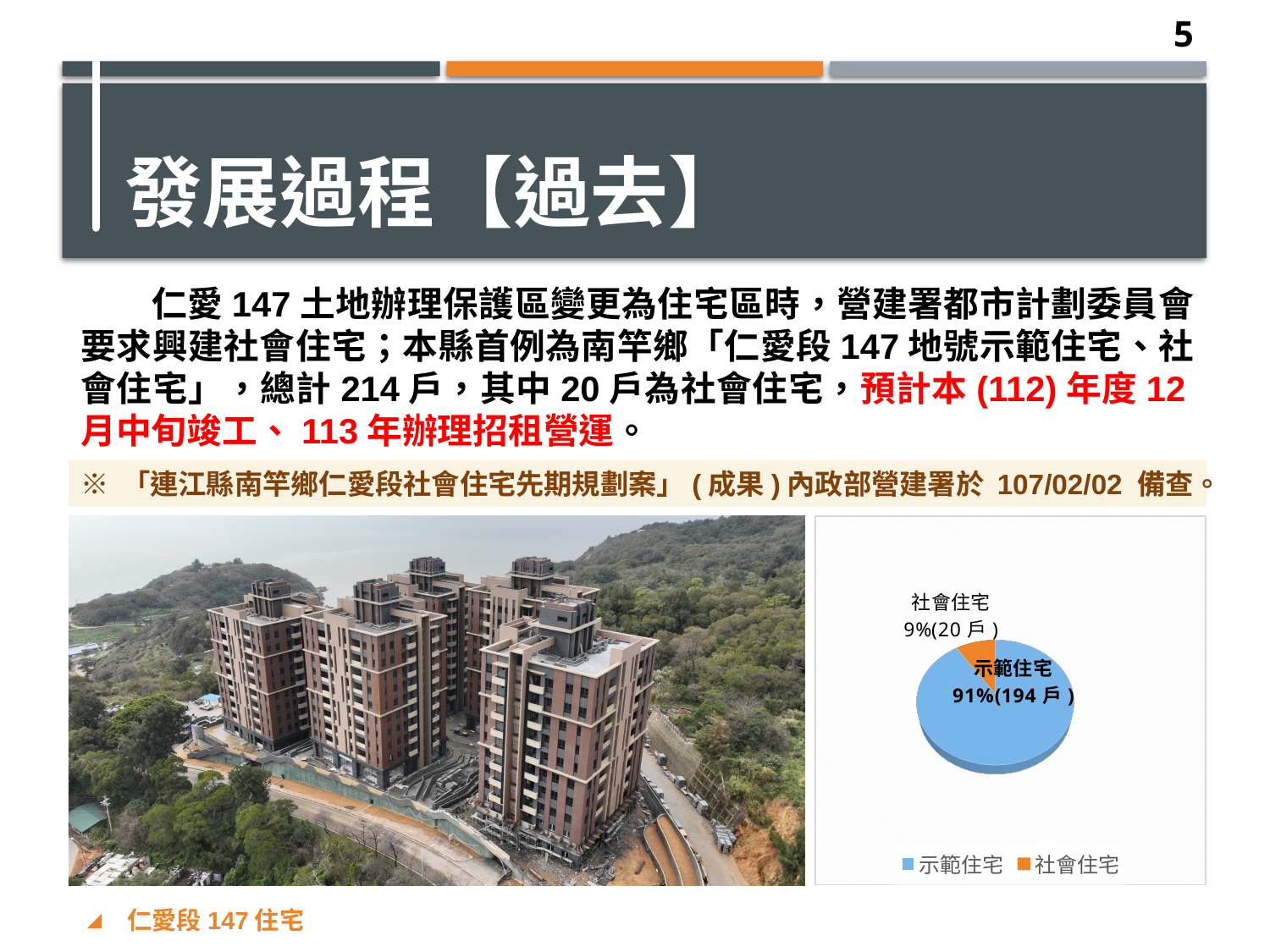
Which slice of the pie chart is the largest? 示範住宅 What percentage of the pie chart does 社會住宅 represent? 9% What is the total number of 戶 across both slices of the pie chart? 214 戶 What percentage of the pie chart does 示範住宅 represent? 91% How many 戶 are labelled for 示範住宅 in the pie chart? 194 戶 How many slices does the pie chart have? 2 Which slice of the pie chart is the smallest? 社會住宅 What kind of chart is shown on the right side of the slide? pie chart How many entries does the pie chart's legend list? 2 How many 戶 are labelled for 社會住宅 in the pie chart? 20 戶 In the pie chart, how many more 戶 does 示範住宅 have than 社會住宅? 174 戶 Which colour represents 社會住宅 in the pie chart? orange